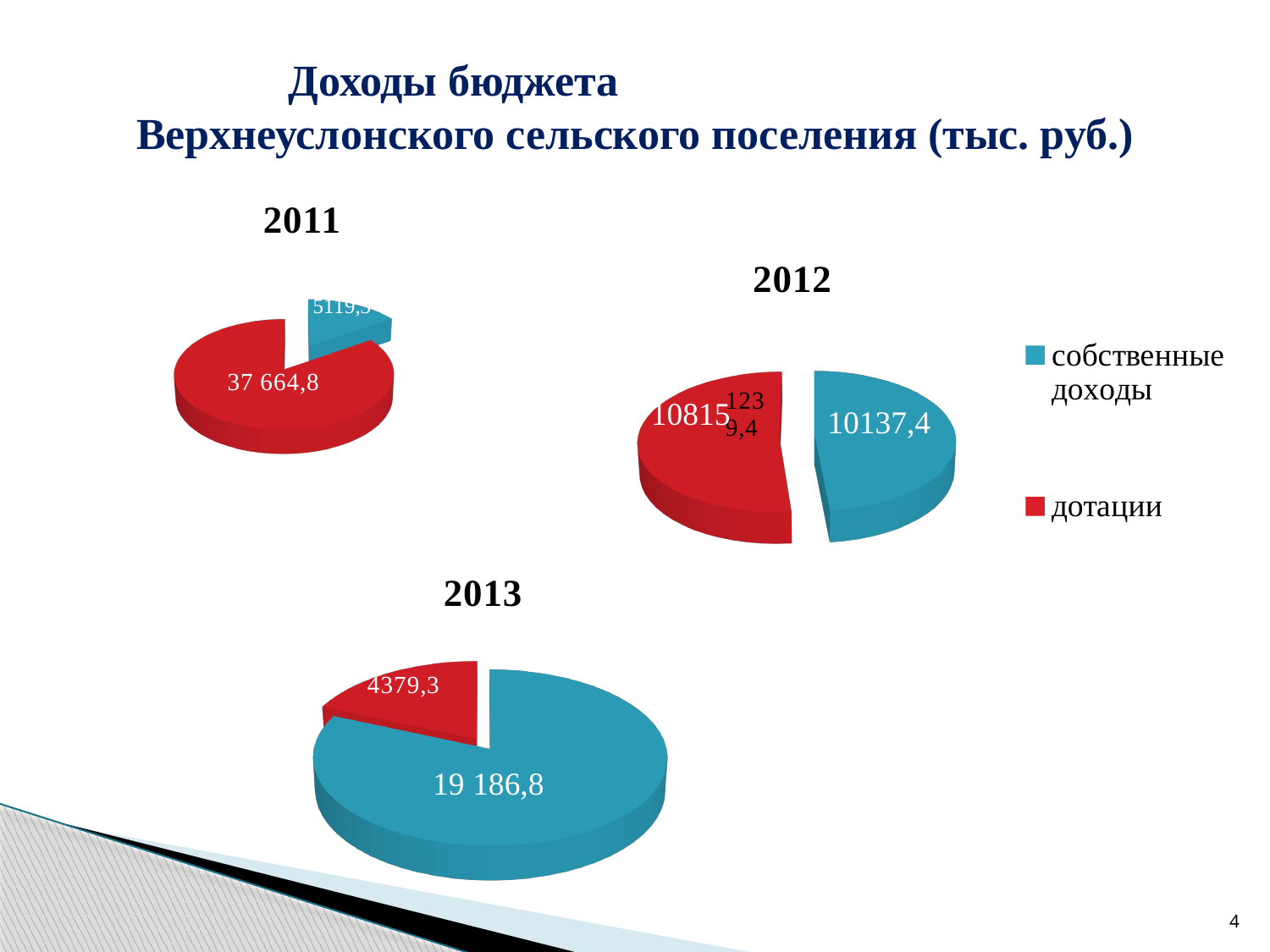
In the 2011 chart, which is larger, дотации or собственные доходы? дотации In the 2013 chart, what is the value for дотации? 4379,3 In the 2013 chart, what is the value for собственные доходы? 19 186,8 In the 2013 chart, what is the total of the two slices? 23 566,1 In the 2012 chart, what is the value for собственные доходы? 10137,4 In the 2011 chart, what is the value for дотации? 37 664,8 In the 2013 chart, what is the difference between собственные доходы and дотации? 14 807,5 In the 2013 chart, which category has the largest slice? собственные доходы Which colour represents дотации in the legend? red How many categories does the legend list? 2 In the 2011 chart, which category has the smallest slice? собственные доходы What kind of chart is used for the 2012 data? pie chart